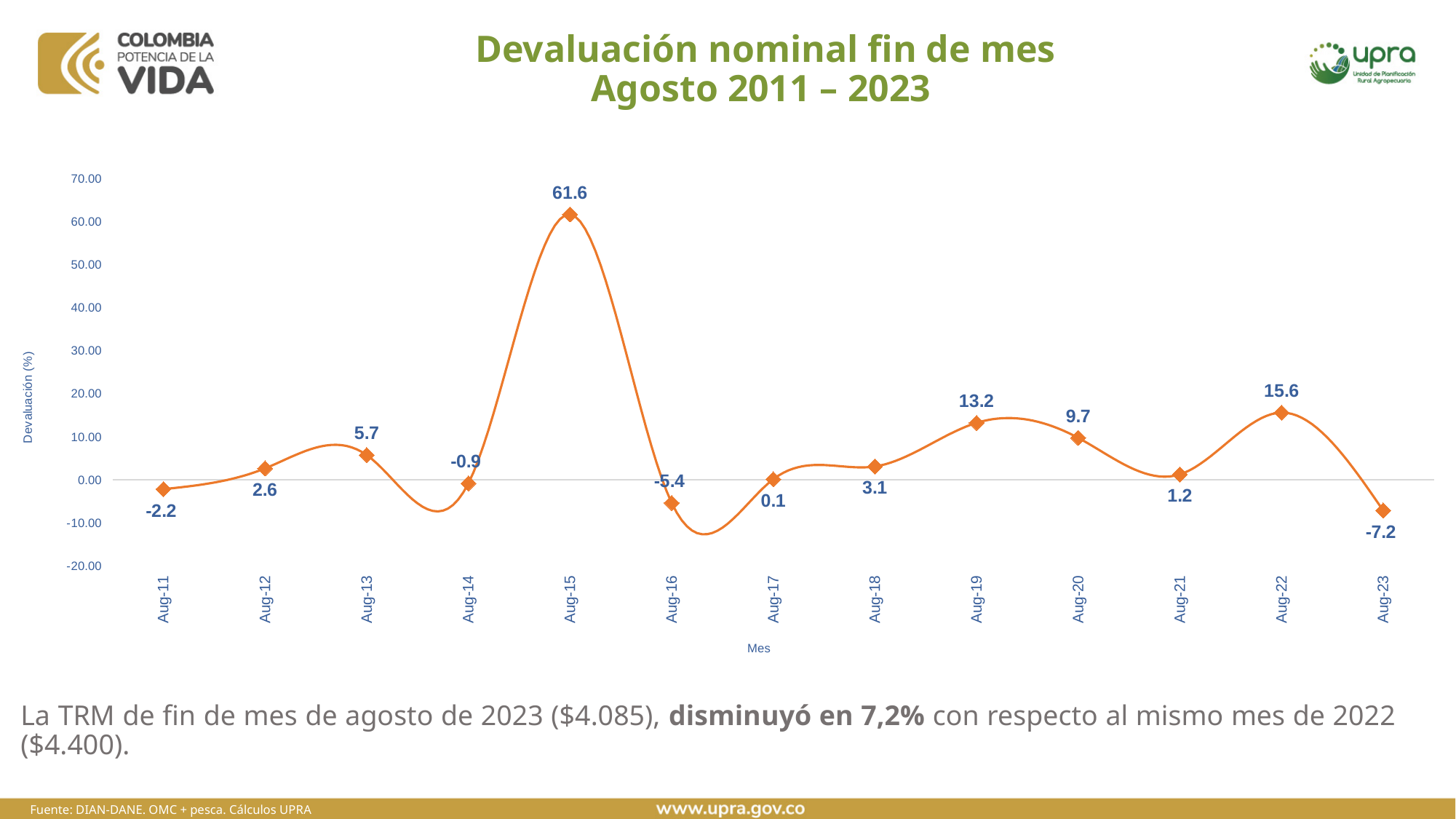
What is the value for Aug-19? 13.2 What is the value for Aug-15? 61.6 What is the title of the chart? Devaluación nominal fin de mes Agosto 2011 – 2023 What is the difference between the values for Aug-22 and Aug-20? 5.9 Is the value for Aug-15 greater or less than 60.00? greater Which month has the highest value? Aug-15 What is the value for Aug-23? -7.2 Which month has the lowest value? Aug-23 What kind of chart is shown? line chart Which is larger, the value for Aug-13 or the value for Aug-18? Aug-13 How many data points are plotted on the chart? 13 Do the values rise or fall from Aug-22 to Aug-23? fall